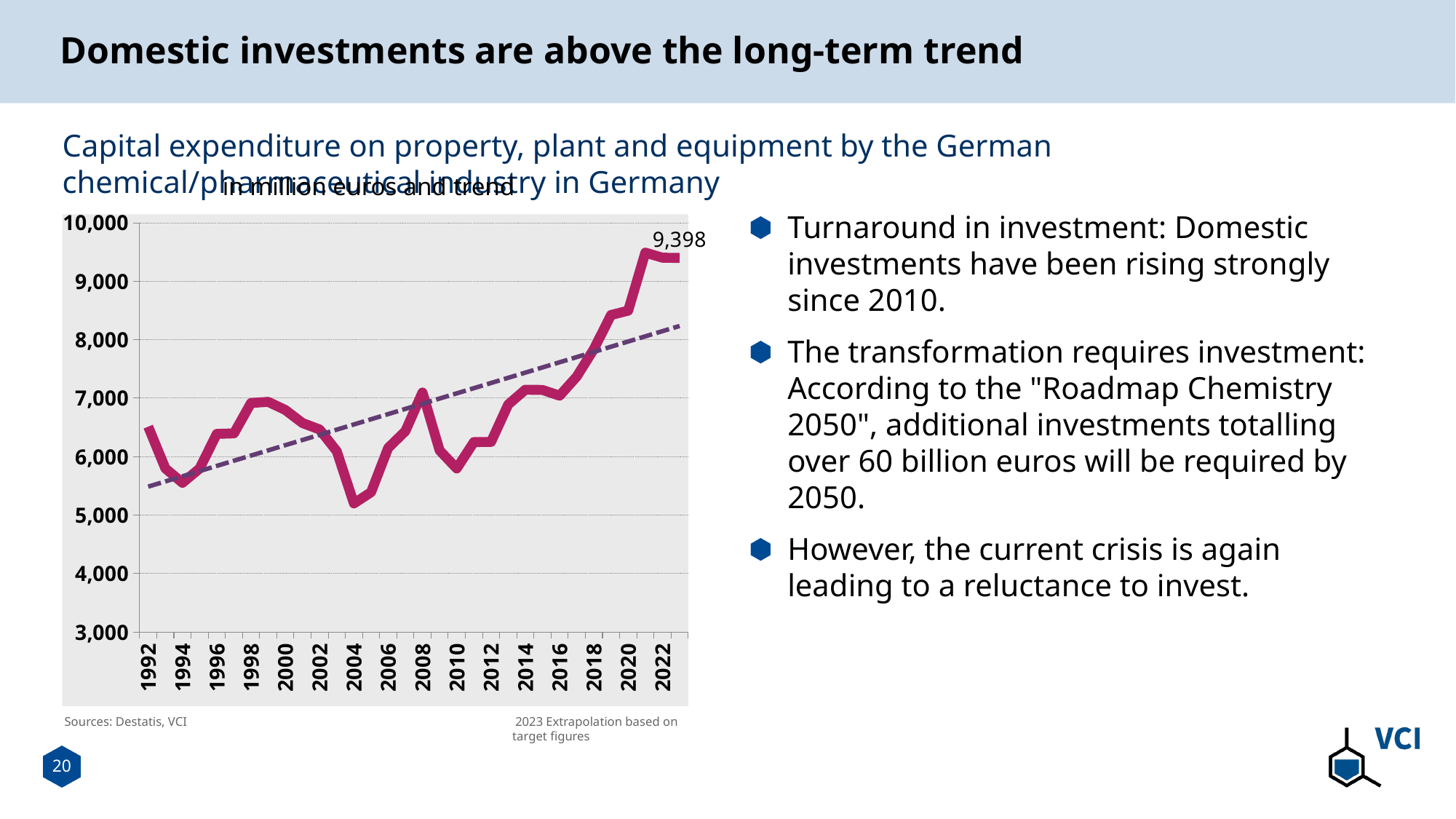
What value is printed as the data label at the end of the line? 9,398 Around which year does the line reach its lowest point? 2004 What unit does the chart subtitle say the values are in? million euros Is the value for 2000 greater or less than 6,000? greater How many year labels are shown on the x axis? 16 Overall, do the values rise or fall from 1992 to 2023? rise Is the value for 2018 greater or less than 8,000? less Which is larger, the value for 1992 or the value for 2004? 1992 Is the value for 2021 greater or less than 9,000? greater What kind of chart is shown on the slide? line chart